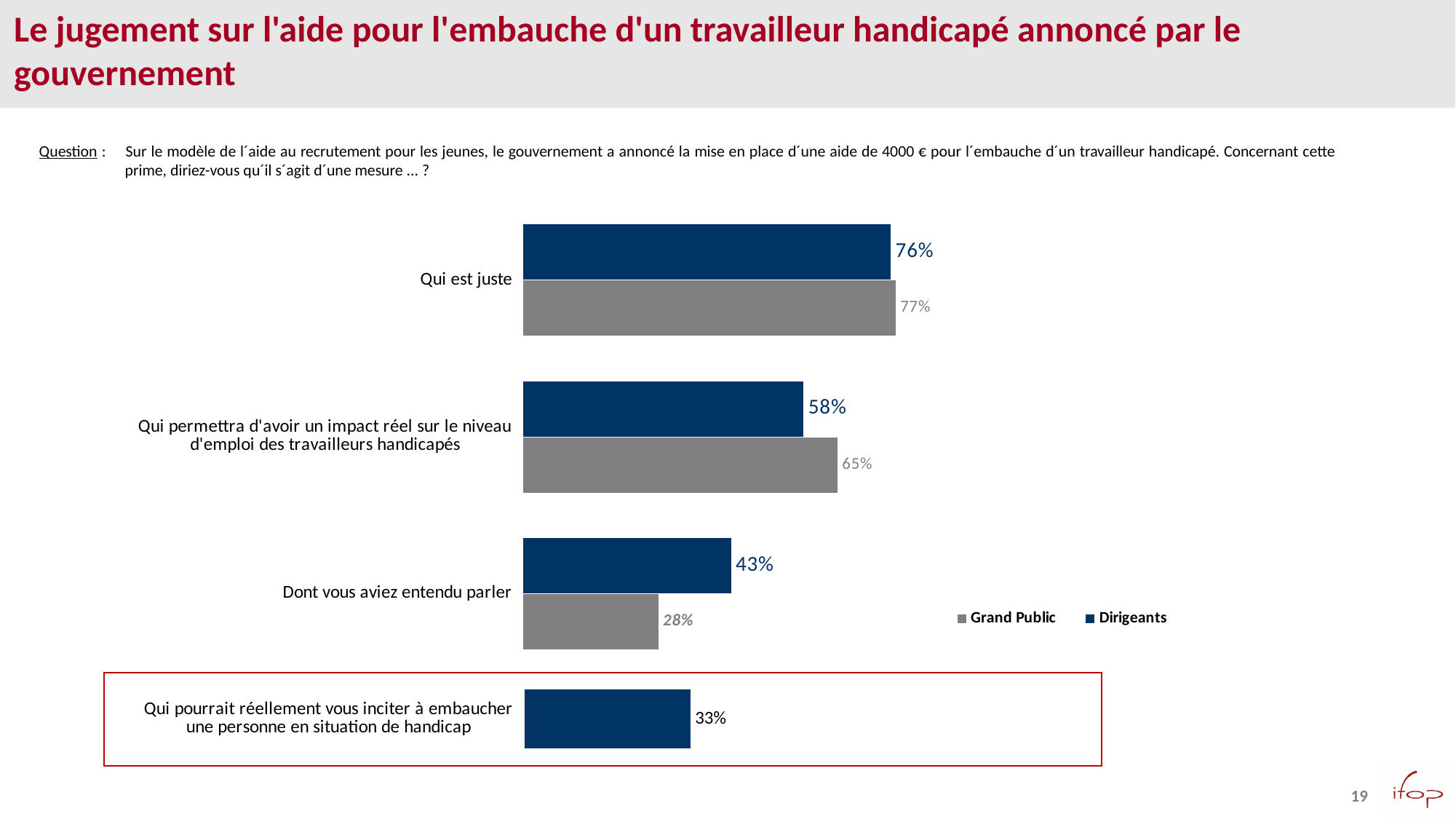
What is the Grand Public value for "Qui permettra d'avoir un impact réel sur le niveau d'emploi des travailleurs handicapés"? 65% What kind of chart is shown on the slide? Bar chart Which category has the lowest Grand Public value? Dont vous aviez entendu parler What is the difference between the Dirigeants and Grand Public values for "Dont vous aviez entendu parler"? 15 percentage points Which colour represents the Dirigeants series? Dark blue How many series does the legend list? 2 Which category has the highest Dirigeants value? Qui est juste What is the Dirigeants value for "Qui est juste"? 76% What is the value for "Qui pourrait réellement vous inciter à embaucher une personne en situation de handicap"? 33% What is the Dirigeants value for "Dont vous aviez entendu parler"? 43% For "Qui permettra d'avoir un impact réel sur le niveau d'emploi des travailleurs handicapés", which is larger: the Dirigeants value or the Grand Public value? Grand Public What is the Grand Public value for "Qui est juste"? 77%